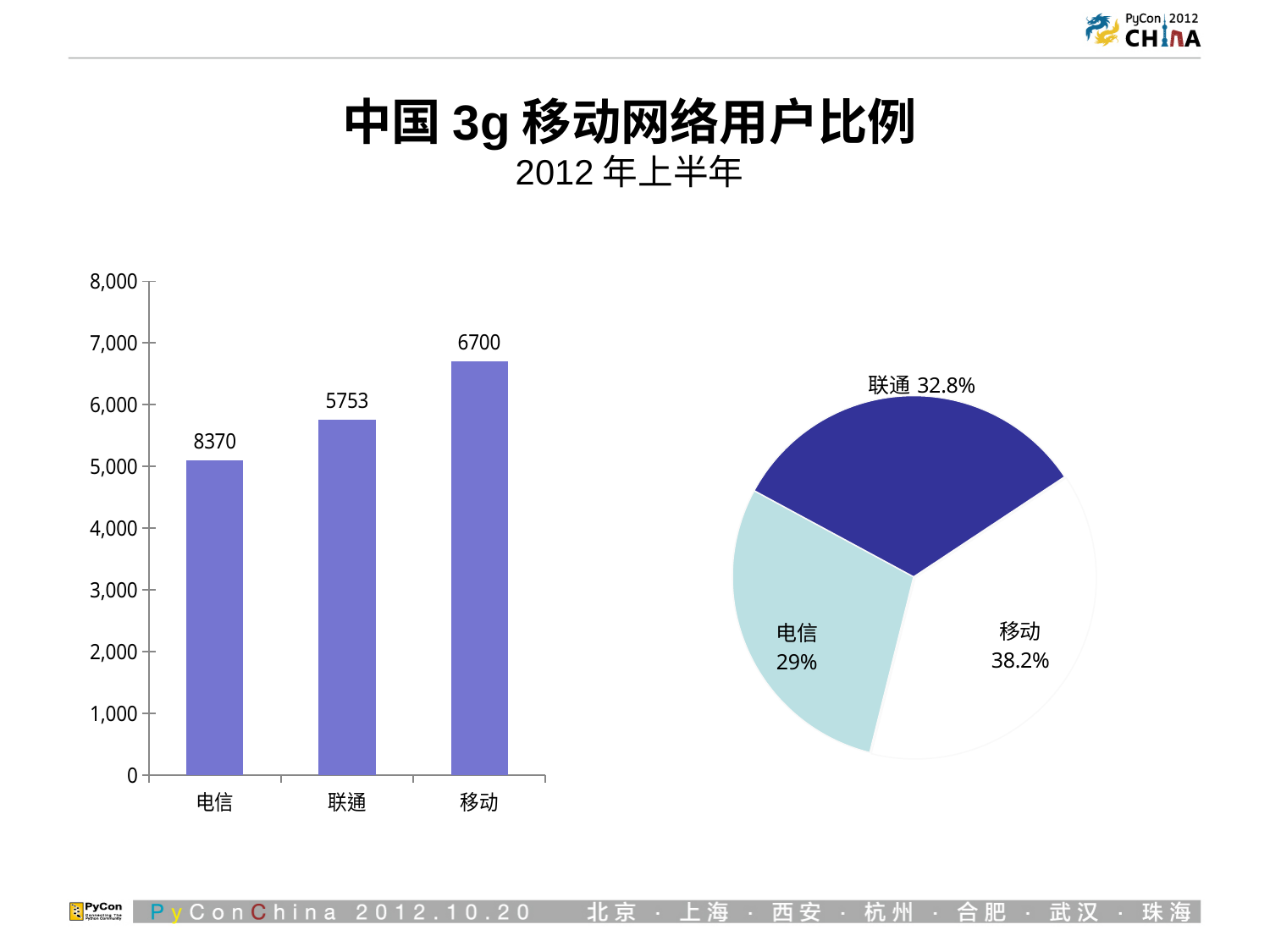
What kind of chart is on the left side of the slide? Bar chart In the bar chart on the left, what is the difference between the labelled values for 移动 and 联通? 947 In the bar chart on the left, how many categories are shown on the x axis? 3 In the bar chart on the left, is the value for 联通 greater or less than 5,000? greater What is the main title of the slide above the charts? 中国 3g 移动网络用户比例 In the bar chart on the left, what value is labelled above the 电信 bar? 8370 In the bar chart on the left, what value is labelled for 联通? 5753 In the bar chart on the left, what value is labelled for 移动? 6700 In the pie chart on the right, which slice is the smallest? 电信 In the bar chart on the left, which is larger, the value for 联通 or the value for 移动? 移动 In the pie chart on the right, what share does 移动 have? 38.2% In the pie chart on the right, which slice is the largest? 移动